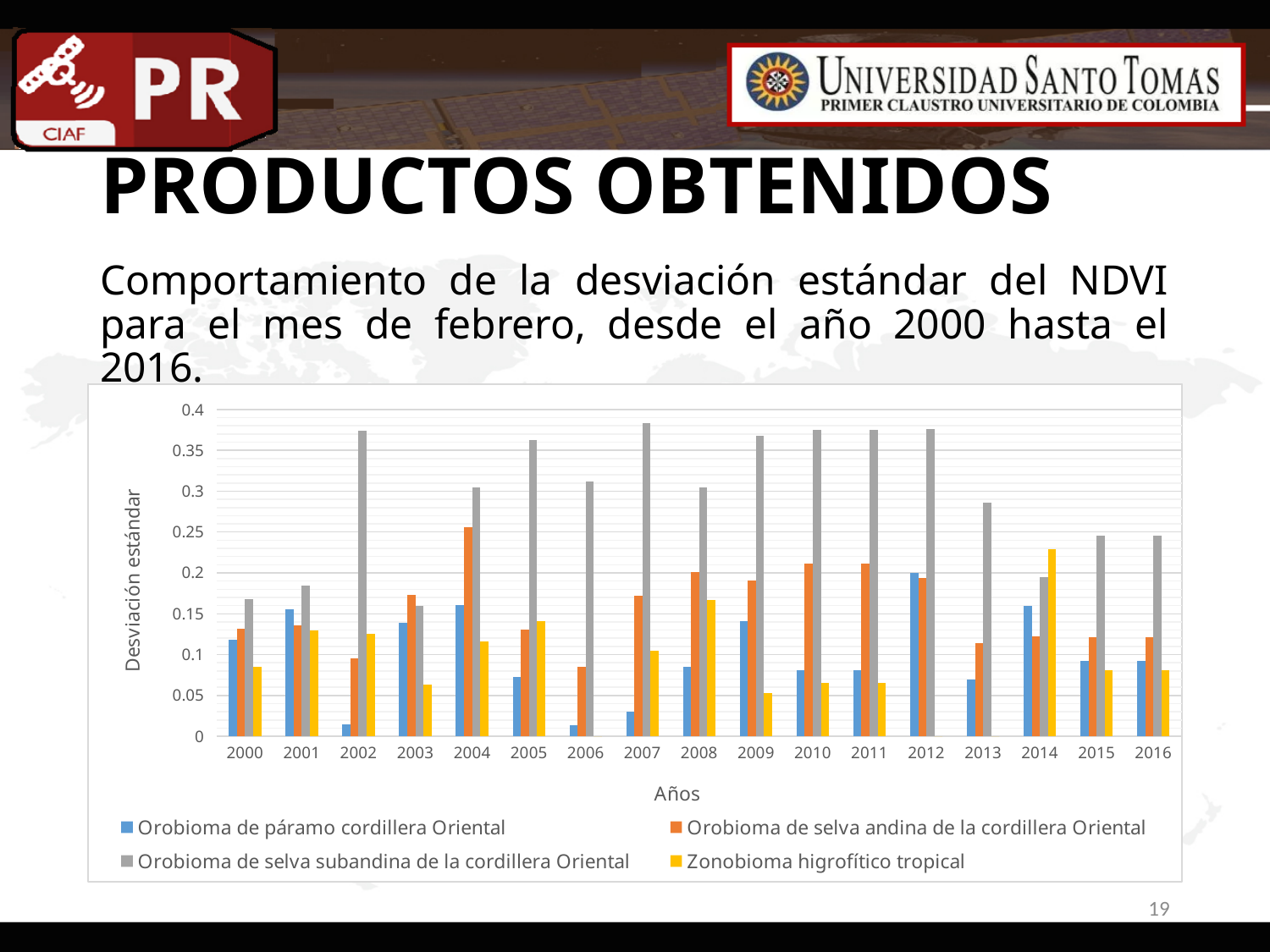
In which year is the value for Orobioma de selva andina de la cordillera Oriental highest? 2004 In which year is the value for Orobioma de páramo cordillera Oriental highest? 2012 In 2014, which is larger: the value for Zonobioma higrofítico tropical or the value for Orobioma de selva subandina de la cordillera Oriental? Zonobioma higrofítico tropical What kind of chart is shown on the slide? Bar chart Is the value for Orobioma de selva subandina de la cordillera Oriental in 2002 greater or less than 0.35? greater What is the title of the horizontal axis of the chart? Años How many years are shown along the x axis of the chart? 17 What is the title of the vertical axis of the chart? Desviación estándar Is the value for Orobioma de páramo cordillera Oriental in 2007 greater or less than 0.05? less How many series does the chart legend list? 4 In which year is the value for Zonobioma higrofítico tropical highest? 2014 Is the value for Orobioma de selva subandina de la cordillera Oriental in 2013 greater or less than 0.3? less